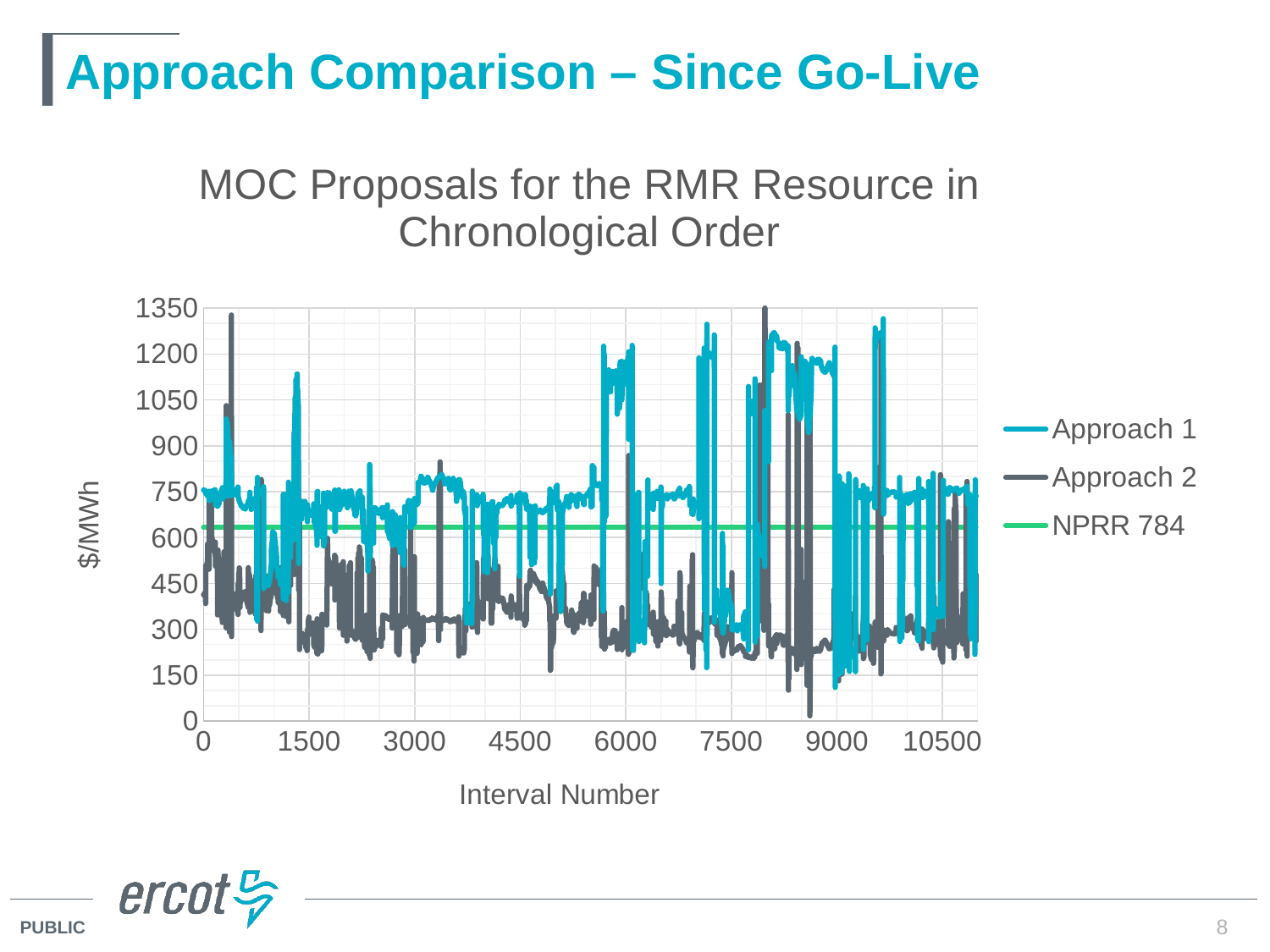
What kind of chart is shown on the slide? Line chart Is the NPRR 784 line greater or less than 750 $/MWh? less Is the value of Approach 2 at interval 3000 greater or less than 600? less How many series does the legend list? 3 What is the label of the y axis? $/MWh Is the value of Approach 1 at interval 3000 greater or less than 450? greater What is the title of the chart? MOC Proposals for the RMR Resource in Chronological Order Which series is generally higher across the intervals, Approach 1 or Approach 2? Approach 1 What is the highest value shown on the y axis? 1350